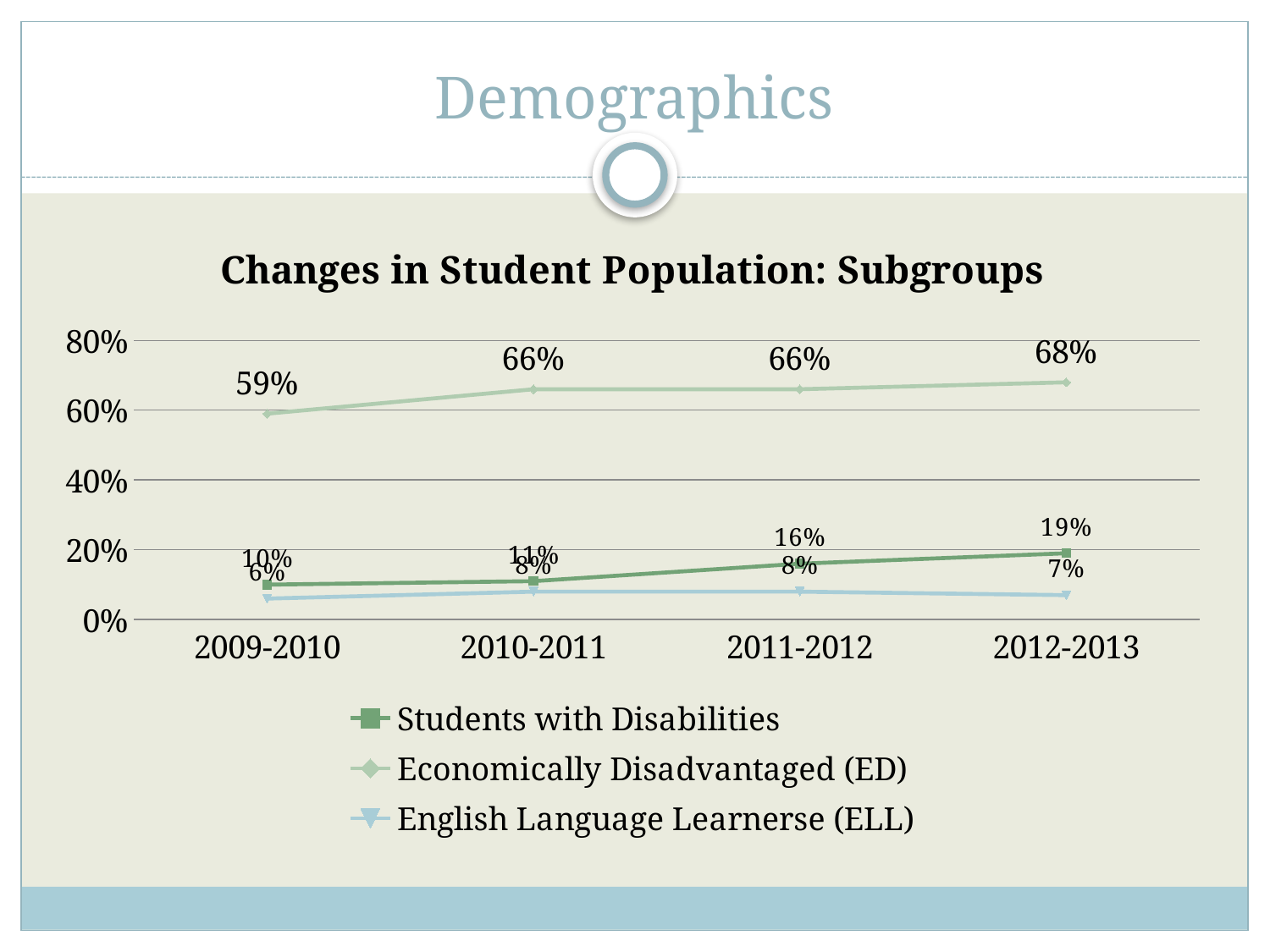
What is the title of the chart? Changes in Student Population: Subgroups Which is larger in 2012-2013: Students with Disabilities or English Language Learnerse (ELL)? Students with Disabilities What kind of chart is shown on the slide? Line chart What is the value for Students with Disabilities in 2012-2013? 19% How many series does the legend list? 3 What is the value for Economically Disadvantaged (ED) in 2012-2013? 68% In which school year is the Economically Disadvantaged (ED) value highest? 2012-2013 How many school years are shown on the x axis? 4 What is the value for Economically Disadvantaged (ED) in 2009-2010? 59% In which school year is the Students with Disabilities value lowest? 2009-2010 What is the difference between the Economically Disadvantaged (ED) values in 2012-2013 and 2009-2010? 9% What is the value for English Language Learnerse (ELL) in 2011-2012? 8%